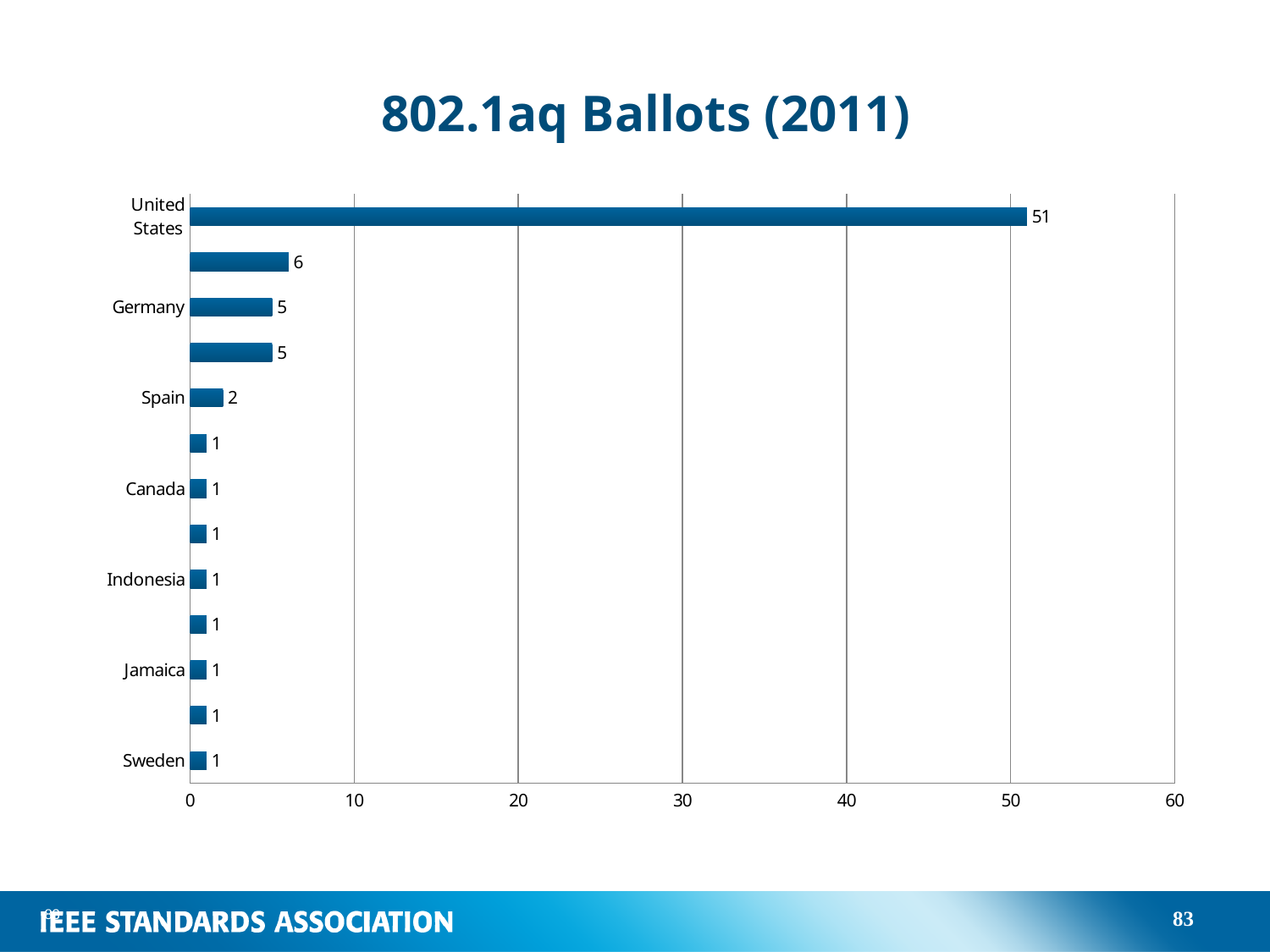
What kind of chart is shown on the slide? bar chart What is the value for Spain? 2 What is the value for United States? 51 What is the value for Canada? 1 What is the value for Germany? 5 What is the value for Sweden? 1 What is the title of the chart? 802.1aq Ballots (2011) What is the difference between the values for United States and Germany? 46 Which is larger, the value for Germany or the value for Spain? Germany Which category has the highest value? United States How many bars are plotted in the chart? 13 Is the value for United States greater or less than 50? greater